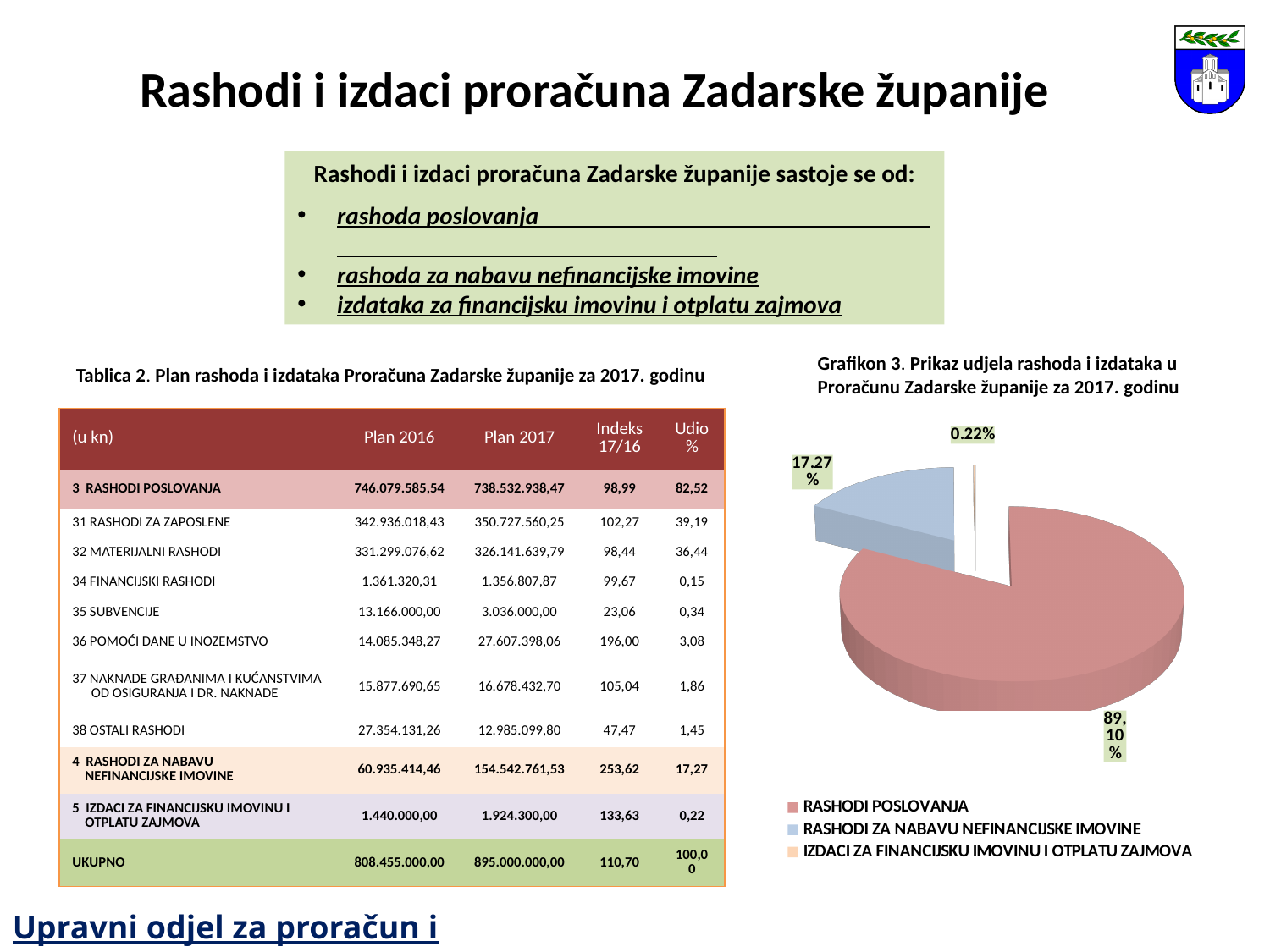
How many entries does the legend of the pie chart list? 3 Which category has the smallest slice in the pie chart? IZDACI ZA FINANCIJSKU IMOVINU I OTPLATU ZAJMOVA What colour is the RASHODI POSLOVANJA slice in the pie chart? pink/red What kind of chart is shown on the slide? pie chart What share of the pie chart is labelled for RASHODI POSLOVANJA? 89,10% Which category has the largest slice in the pie chart? RASHODI POSLOVANJA What share of the pie chart is labelled for RASHODI ZA NABAVU NEFINANCIJSKE IMOVINE? 17.27% By how many percentage points does the RASHODI ZA NABAVU NEFINANCIJSKE IMOVINE slice exceed the IZDACI ZA FINANCIJSKU IMOVINU I OTPLATU ZAJMOVA slice? 17.05 What is the title of the pie chart? Grafikon 3. Prikaz udjela rashoda i izdataka u Proračunu Zadarske županije za 2017. godinu How many slices does the pie chart have? 3 What share of the pie chart is labelled for IZDACI ZA FINANCIJSKU IMOVINU I OTPLATU ZAJMOVA? 0.22% Which slice is larger: RASHODI ZA NABAVU NEFINANCIJSKE IMOVINE or IZDACI ZA FINANCIJSKU IMOVINU I OTPLATU ZAJMOVA? RASHODI ZA NABAVU NEFINANCIJSKE IMOVINE